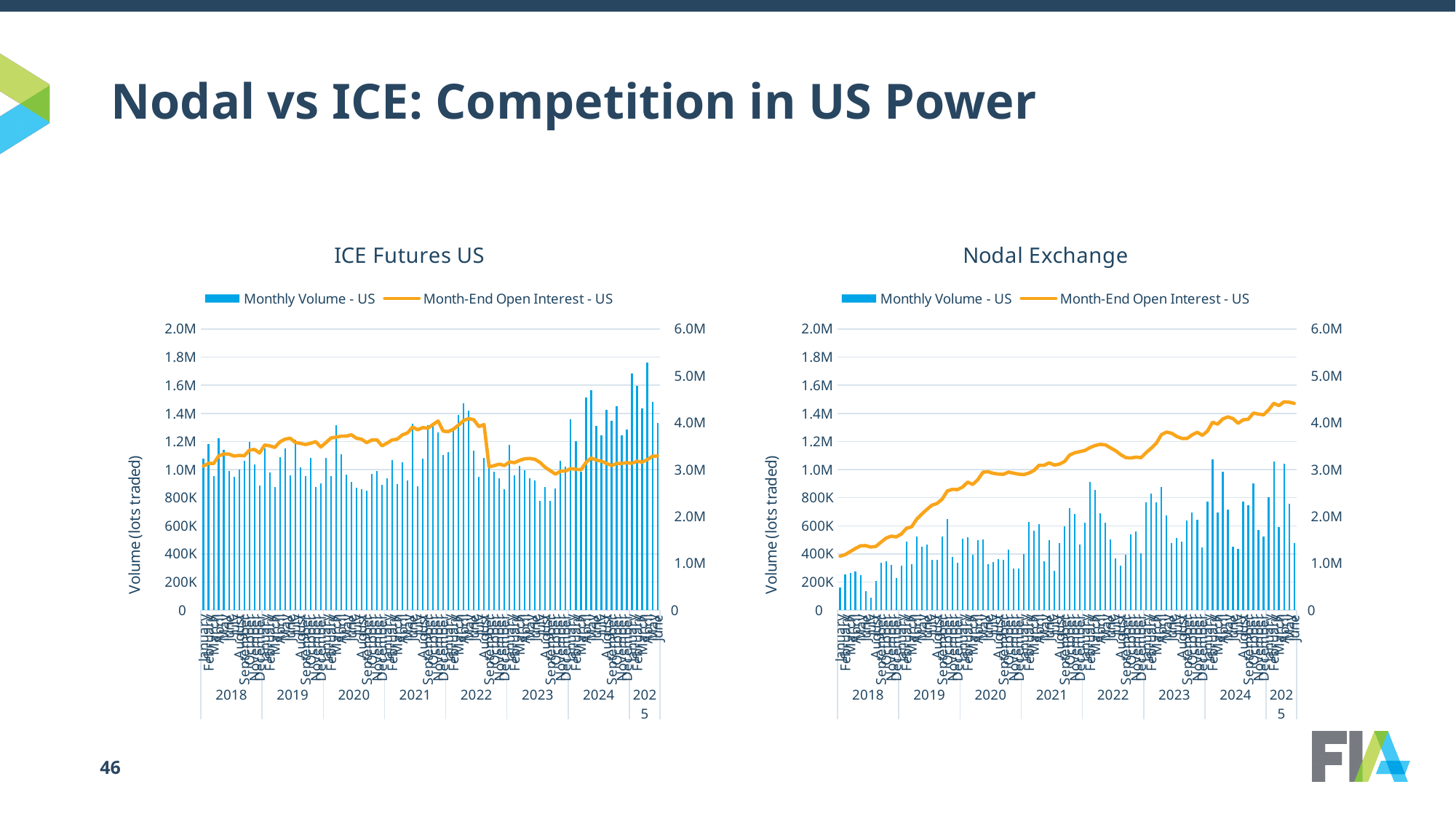
In the Nodal Exchange chart, is the Month-End Open Interest at the end of the series in 2025 greater or less than 4.0M? greater In the Nodal Exchange chart, is the Monthly Volume in early 2018 greater or less than 600K? less What is the title of the chart on the right side of the slide? Nodal Exchange In the ICE Futures US chart, is the Monthly Volume in early 2018 greater or less than 800K? greater Comparing the two charts, which exchange has the higher Month-End Open Interest at the end of the series in 2025, ICE Futures US or Nodal Exchange? Nodal Exchange How many series does the legend of the Nodal Exchange chart list? 2 In the Nodal Exchange chart, does the Month-End Open Interest line rise or fall from 2018 to 2025? Rise Comparing the two charts, which exchange has the higher Month-End Open Interest at the start of 2018, ICE Futures US or Nodal Exchange? ICE Futures US What type of chart is the ICE Futures US chart? Combination bar and line chart In the ICE Futures US chart, which series is drawn as a line? Month-End Open Interest - US